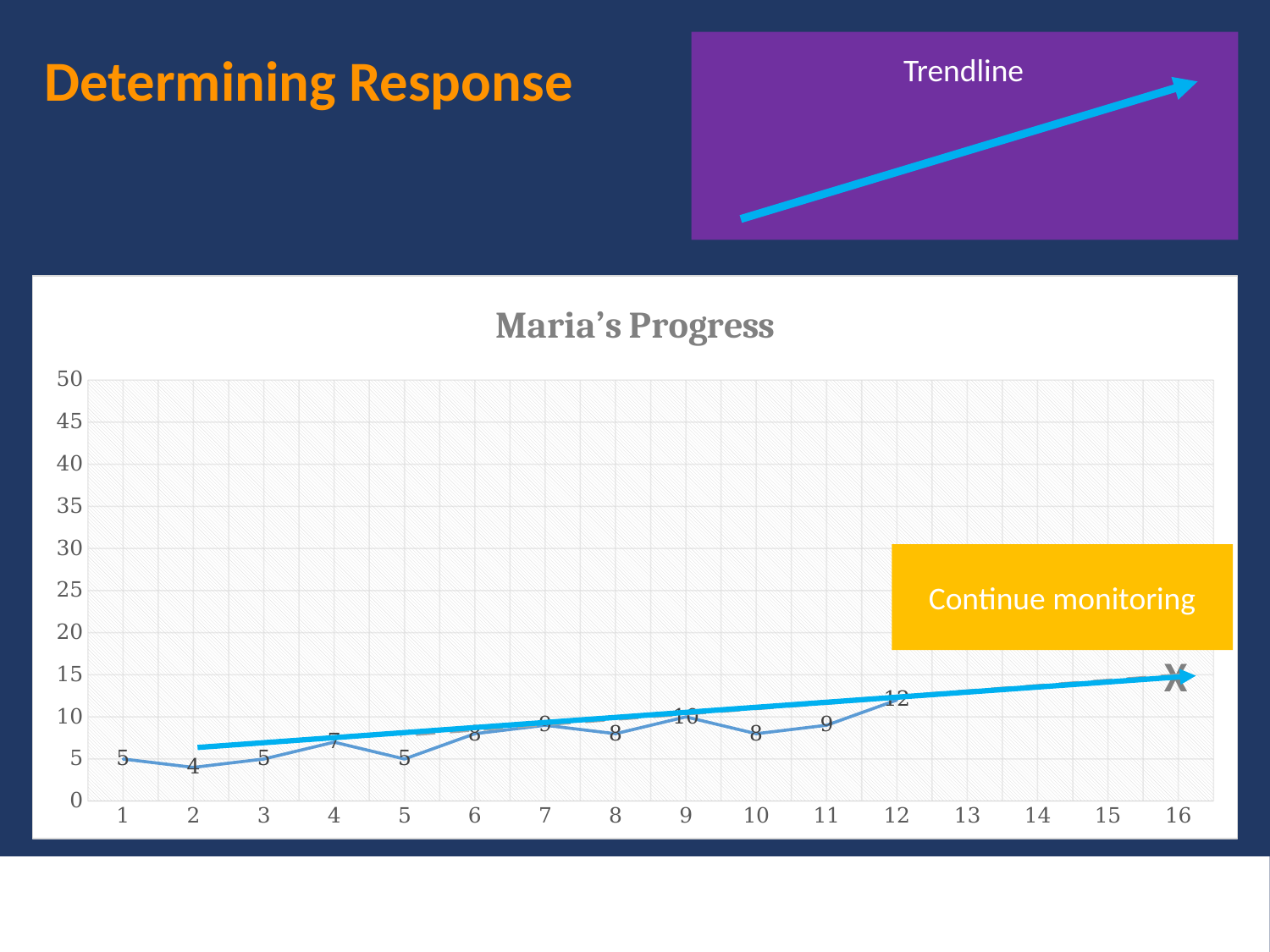
What is the title of the chart? Maria's Progress What is the value plotted at point 12? 12 What kind of chart is shown on the slide? line chart What is the value plotted at point 6? 8 Do the plotted values generally rise or fall from left to right along the x axis? rise What is the difference between the value at point 12 and the value at point 1? 7 What is the value plotted at point 1? 5 Which is larger, the value at point 9 or the value at point 10? point 9 At which point on the x axis is the plotted value highest? 12 What is the value plotted at point 2? 4 How many data points are plotted on the line? 12 At which point on the x axis is the plotted value lowest? 2